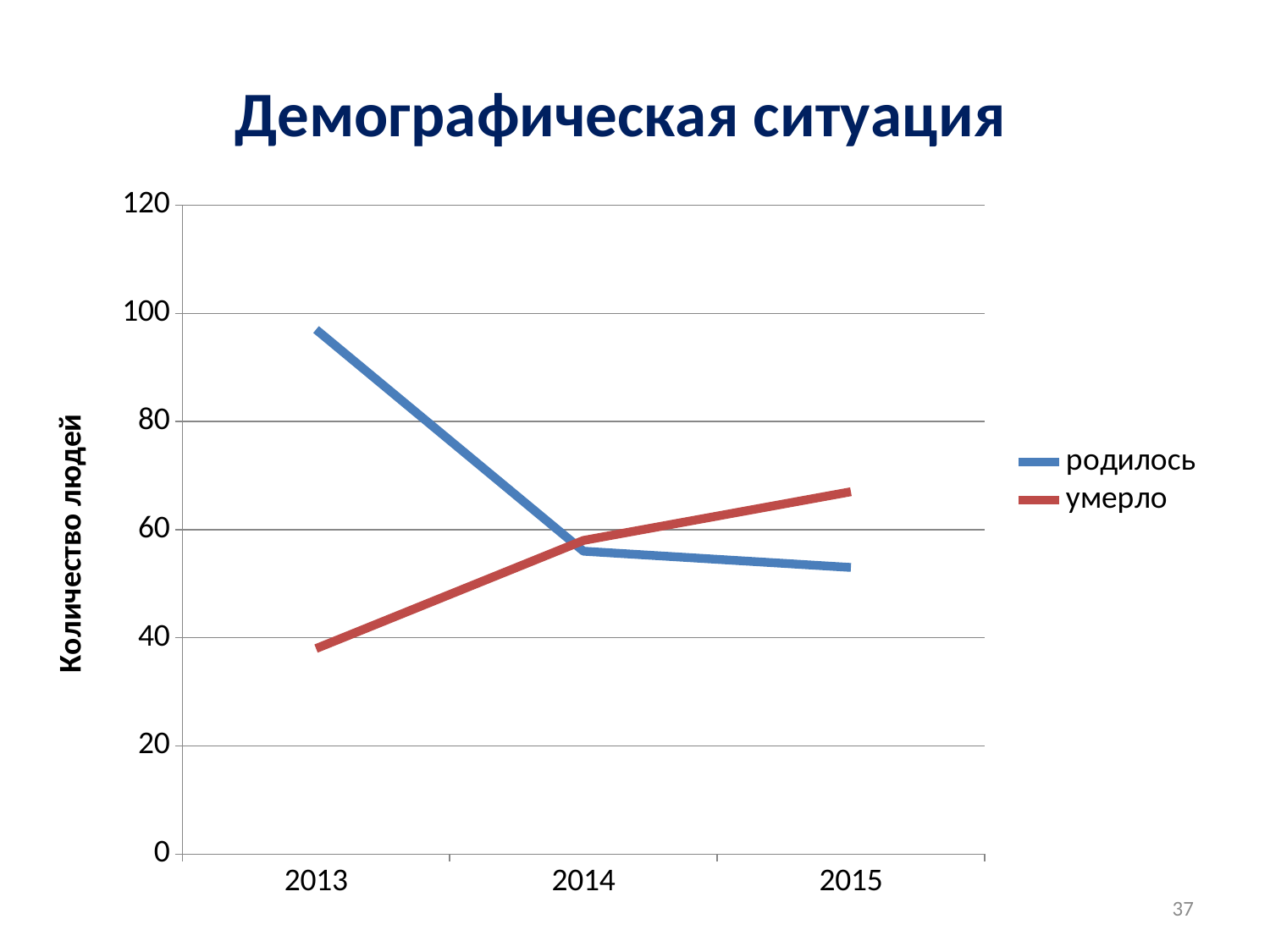
How many years are plotted along the x axis? 3 In 2013, which is larger: родилось or умерло? родилось In which year is the value for умерло lowest? 2013 In which year is the value for родилось highest? 2013 Does the value for умерло rise or fall from 2013 to 2015? rise Does the value for родилось rise or fall from 2013 to 2015? fall In which year is the value for умерло highest? 2015 What kind of chart is shown on the slide? line chart Is the value for родилось in 2013 greater or less than 80? greater In 2015, which is larger: родилось or умерло? умерло How many series does the legend list? 2